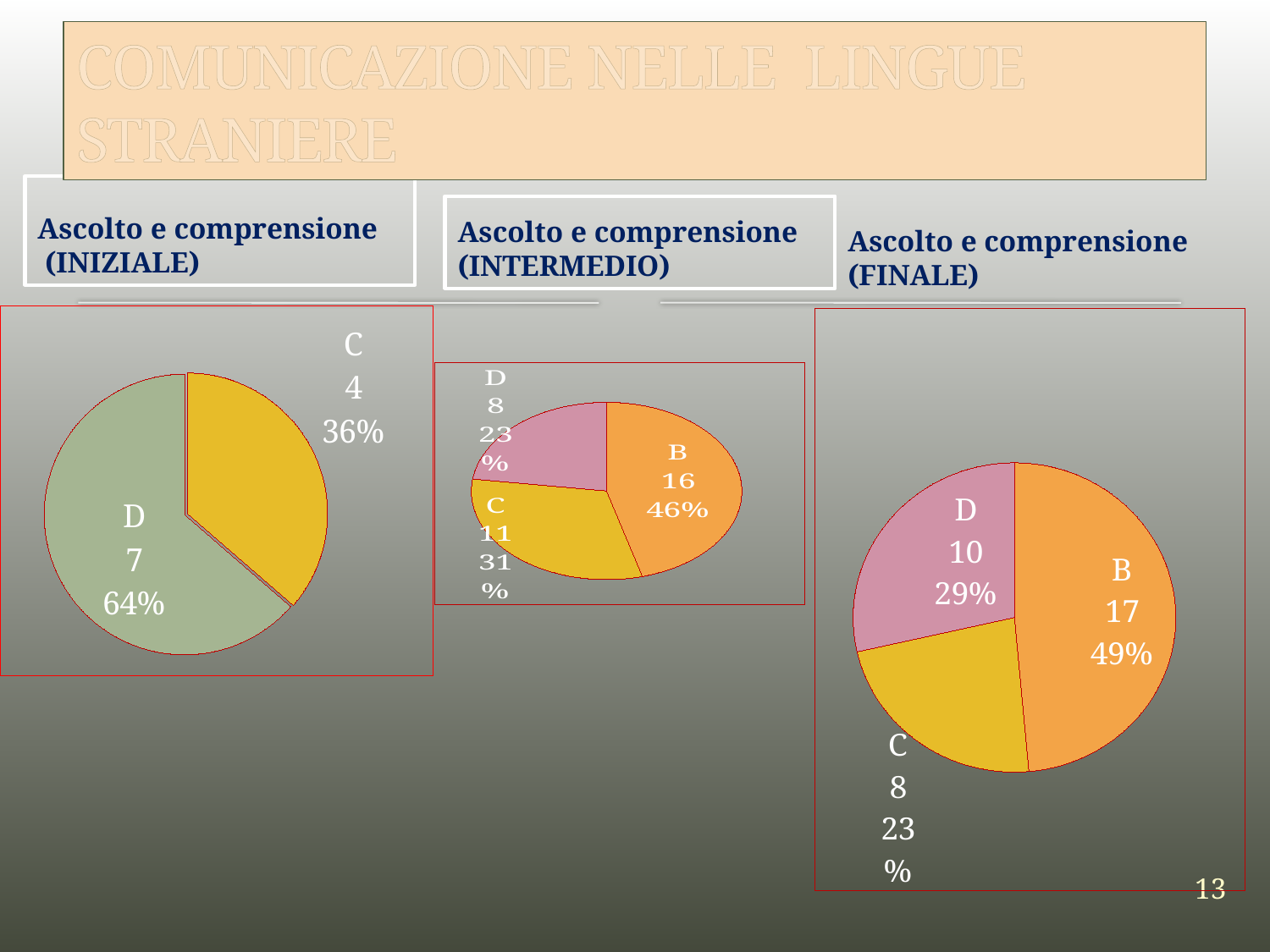
In the 'Ascolto e comprensione (INIZIALE)' chart, what share of the pie does category C have? 36% In the 'Ascolto e comprensione (INIZIALE)' chart, what value is shown for category D? 7 In the 'Ascolto e comprensione (INIZIALE)' chart, how many slices does the pie have? 2 In the 'Ascolto e comprensione (FINALE)' chart, which category has the largest slice? B In the 'Ascolto e comprensione (FINALE)' chart, which is larger, the value for D or the value for C? D In the 'Ascolto e comprensione (FINALE)' chart, what value is shown for category D? 10 In the 'Ascolto e comprensione (INTERMEDIO)' chart, what share of the pie does category C have? 31% In the 'Ascolto e comprensione (INTERMEDIO)' chart, which category has the smallest slice? D In the 'Ascolto e comprensione (FINALE)' chart, what share of the pie does category C have? 23% In the 'Ascolto e comprensione (INTERMEDIO)' chart, what is the difference between the values for B and C? 5 In the 'Ascolto e comprensione (INTERMEDIO)' chart, what value is shown for category B? 16 What kind of chart is used for 'Ascolto e comprensione (FINALE)'? Pie chart